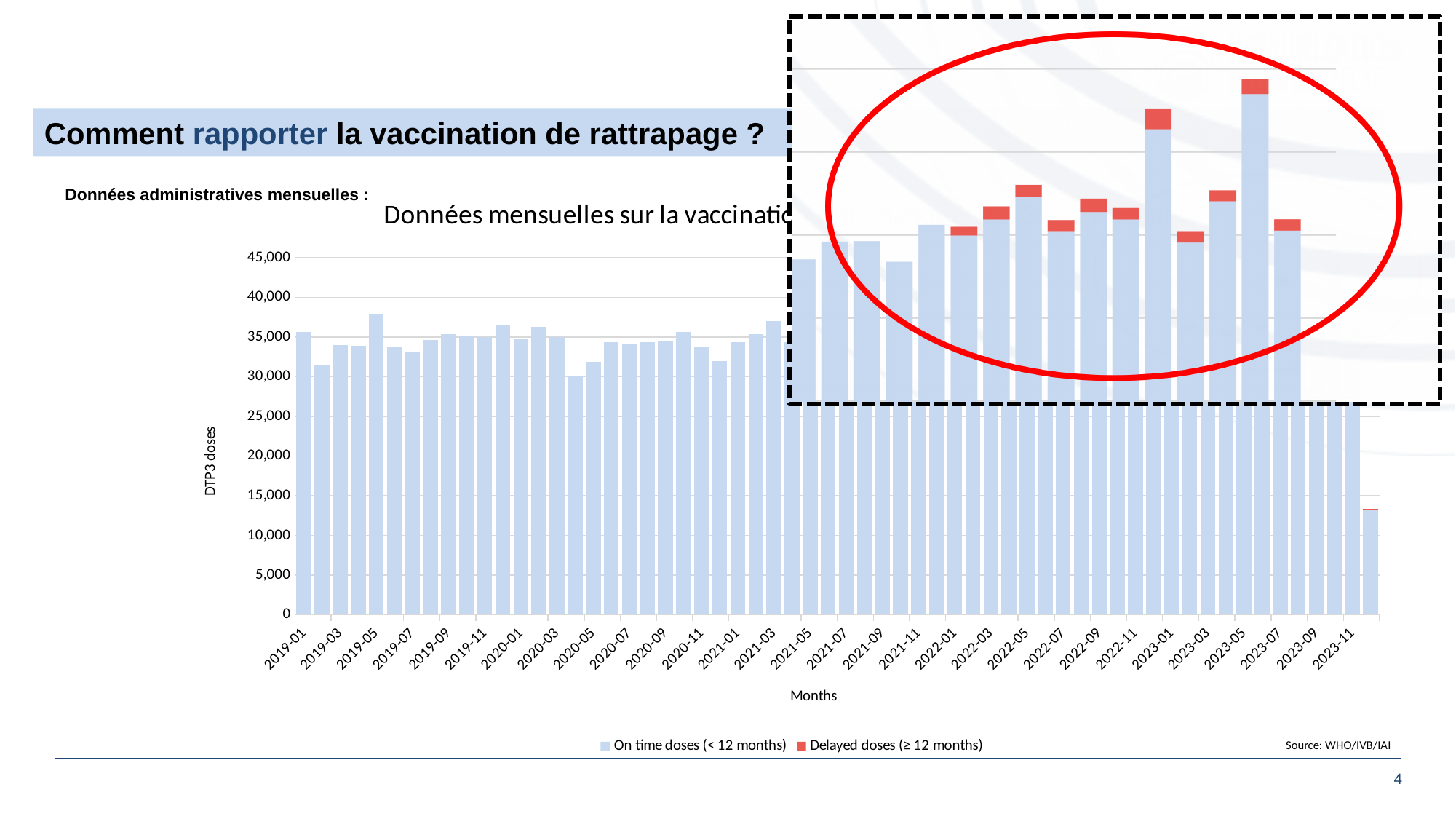
What are the two series named in the chart's legend? On time doses (< 12 months) and Delayed doses (≥ 12 months) Is the value for 2020-05 greater or less than 35,000? less What is the label of the vertical axis of the chart? DTP3 doses Is the value for the final month shown on the chart greater or less than 15,000? less Is the value for 2019-05 greater or less than 35,000? greater What kind of chart is shown on the slide? Stacked bar chart How many series does the chart's legend list? 2 Which month has a higher value, 2020-03 or 2020-05? 2020-03 Which bar on the chart is the lowest? The final month shown (after 2023-11) Which month has a higher value, 2019-05 or 2019-02? 2019-05